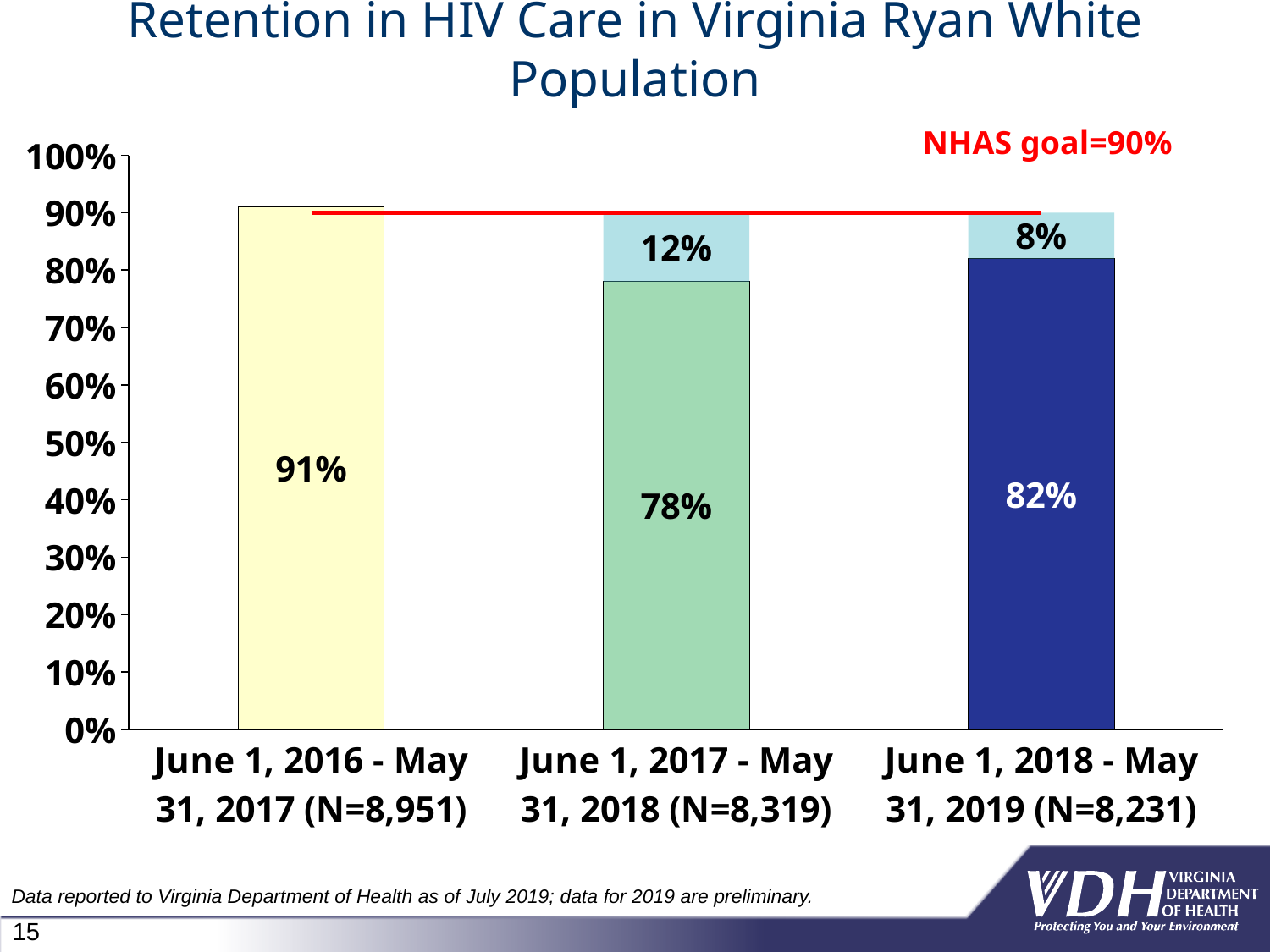
What is the value of the upper (light blue) segment for June 1, 2018 - May 31, 2019 (N=8,231)? 8% Is the lower segment value for June 1, 2018 - May 31, 2019 larger or smaller than that for June 1, 2017 - May 31, 2018? larger What is the total of the stacked bar for June 1, 2017 - May 31, 2018 (N=8,319)? 90% What is the retention value shown for June 1, 2016 - May 31, 2017 (N=8,951)? 91% What is the value of the upper (light blue) segment for June 1, 2017 - May 31, 2018 (N=8,319)? 12% Which period has the lowest value for its lower (main) bar segment? June 1, 2017 - May 31, 2018 (N=8,319) What is the value of the lower (green) segment for June 1, 2017 - May 31, 2018 (N=8,319)? 78% How many time periods are shown on the x axis? 3 What is the total of the stacked bar for June 1, 2018 - May 31, 2019 (N=8,231)? 90% What NHAS goal value is marked by the red line on the chart? 90% Which period has the highest value for its lower (main) bar segment? June 1, 2016 - May 31, 2017 (N=8,951) What is the difference between the lower segment values for June 1, 2018 - May 31, 2019 and June 1, 2017 - May 31, 2018? 4%